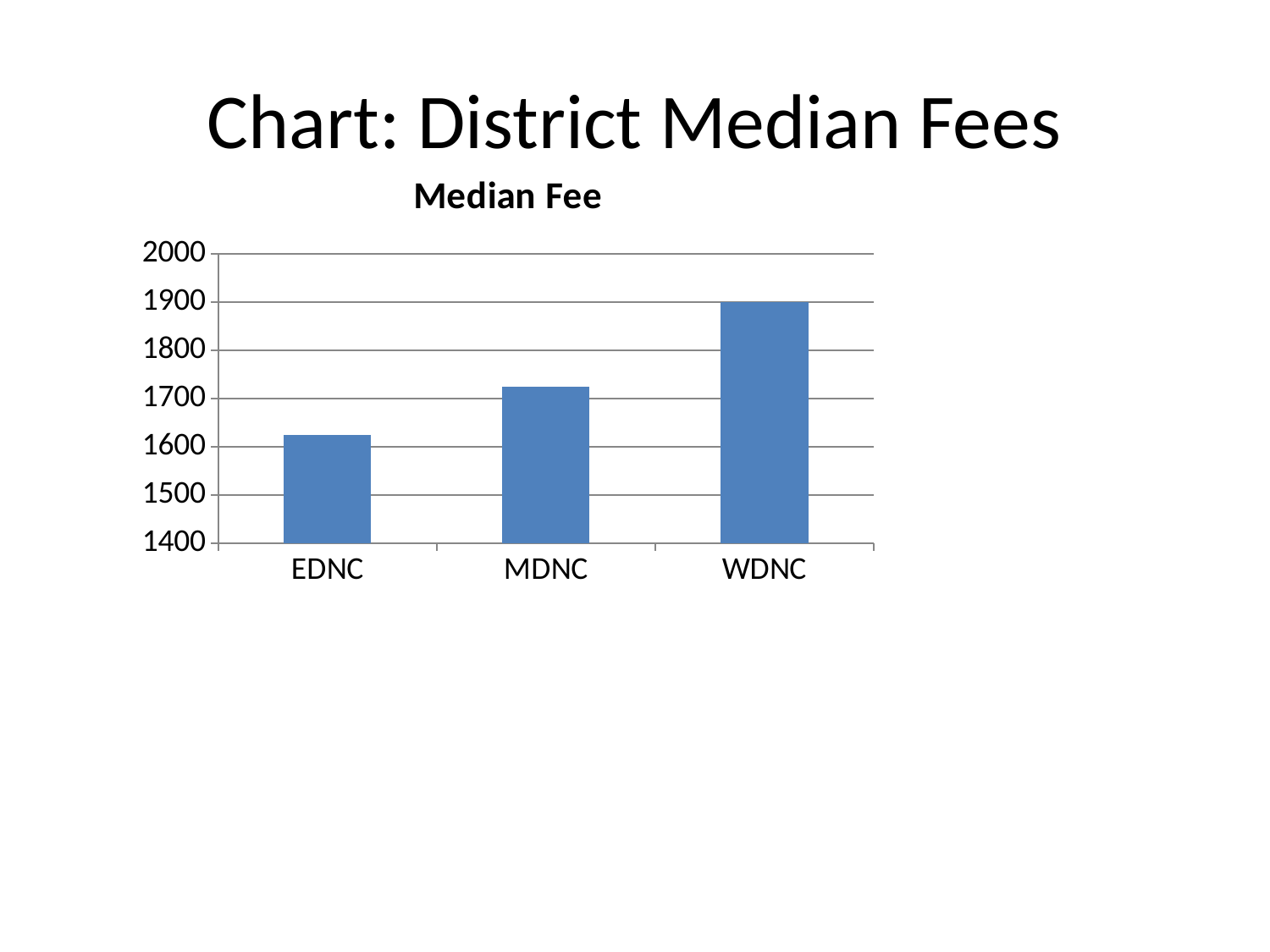
Is the median fee for EDNC greater or less than 1700? less Is the median fee for MDNC greater or less than 1700? greater Which district has the highest median fee? WDNC Is the median fee for WDNC greater or less than 1800? greater How many categories are plotted in the Median Fee chart? 3 Which has a higher median fee, EDNC or MDNC? MDNC What kind of chart is shown on the slide? bar chart Which district has the lowest median fee? EDNC Do the median fees rise or fall moving from EDNC to WDNC along the x axis? rise Which has a higher median fee, MDNC or WDNC? WDNC What is the title of the chart? Median Fee